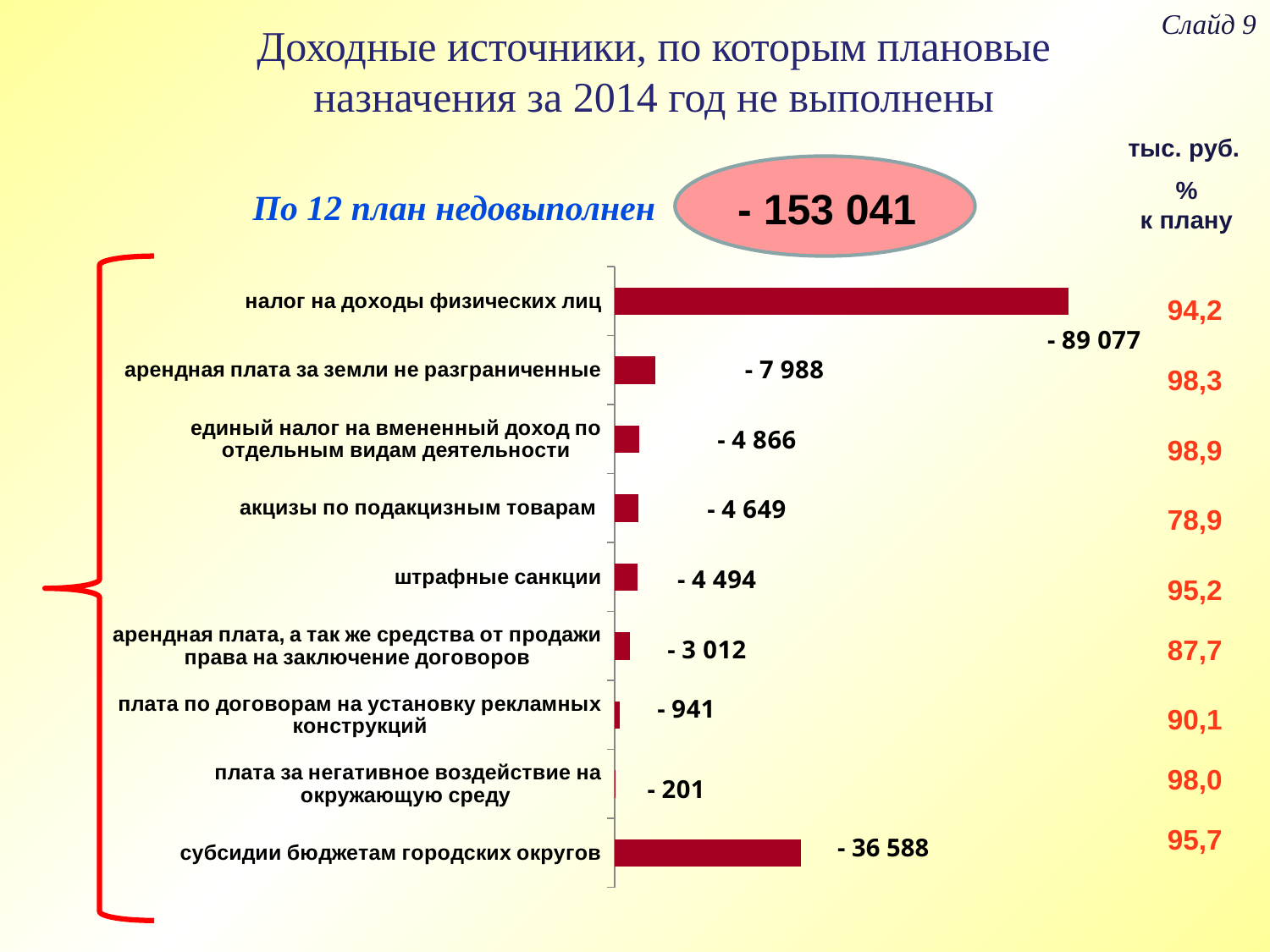
Which bar is longer: арендная плата за земли не разграниченные or штрафные санкции? арендная плата за земли не разграниченные What is the value shown for плата за негативное воздействие на окружающую среду? - 201 Which category has the longest bar in the chart? налог на доходы физических лиц What kind of chart is shown on the slide? bar chart Which category has the shortest bar in the chart? плата за негативное воздействие на окружающую среду What is the difference between the values for арендная плата за земли не разграниченные (- 7 988) and единый налог на вмененный доход по отдельным видам деятельности (- 4 866)? 3 122 What is the value shown for налог на доходы физических лиц? - 89 077 How many categories are plotted in the chart? 9 What is the value shown for субсидии бюджетам городских округов? - 36 588 What is the difference between the values for налог на доходы физических лиц (- 89 077) and субсидии бюджетам городских округов (- 36 588)? 52 489 What is the value shown for акцизы по подакцизным товарам? - 4 649 What total is shown in the oval above the chart? - 153 041